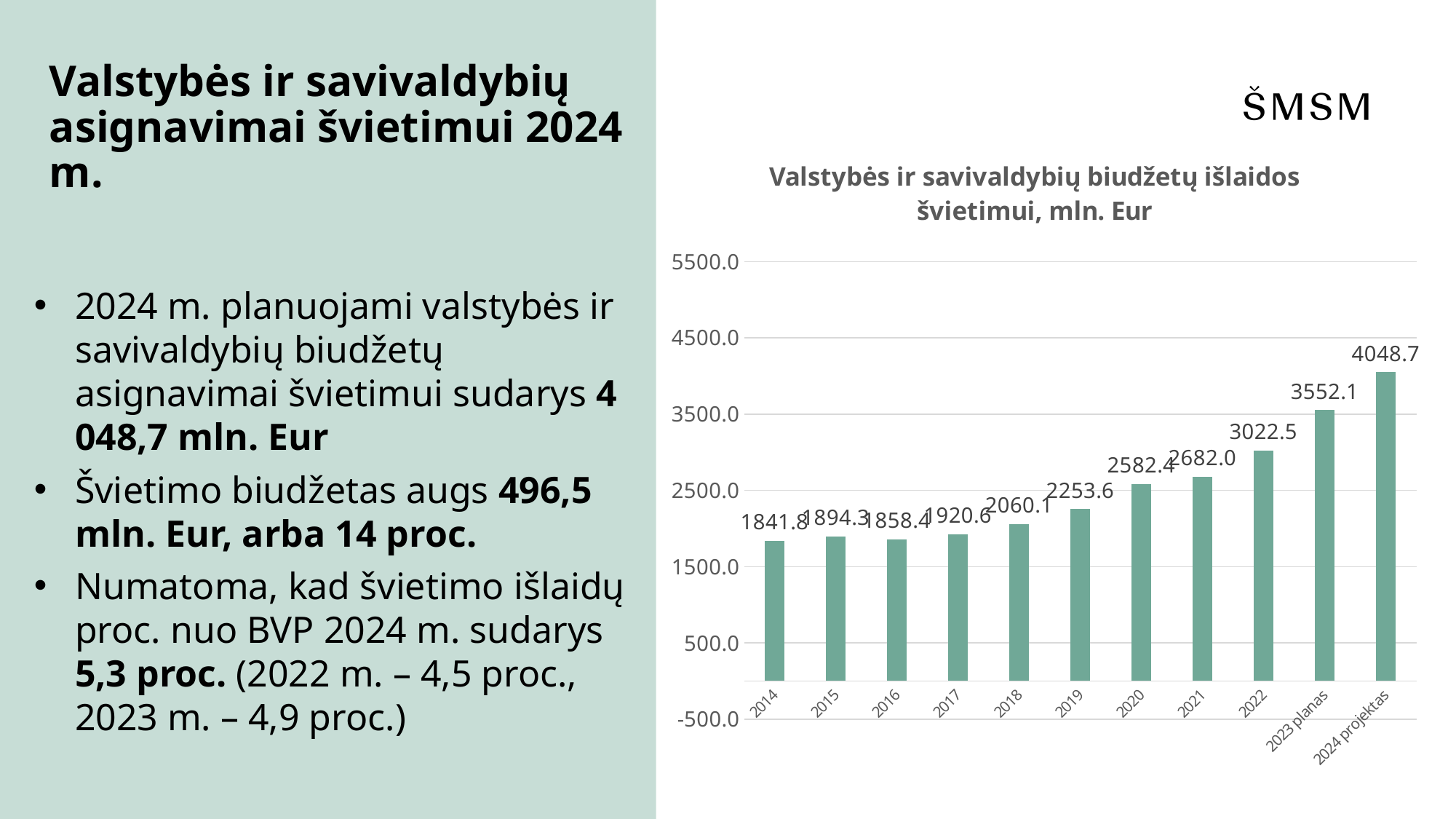
What is the value for 2019? 2253.6 What kind of chart is shown? bar chart What is the value for 2023 planas? 3552.1 Do the values generally rise or fall from 2016 to 2024 projektas? rise Is the value for 2021 greater or less than 3500? less What is the value for 2024 projektas? 4048.7 What is the value for 2022? 3022.5 What is the difference between the values for 2022 and 2021? 340.5 How many categories are shown on the x axis? 11 Which category has the highest value? 2024 projektas What is the difference between the values for 2024 projektas and 2023 planas? 496.6 Which is larger, the value for 2018 or the value for 2017? 2018